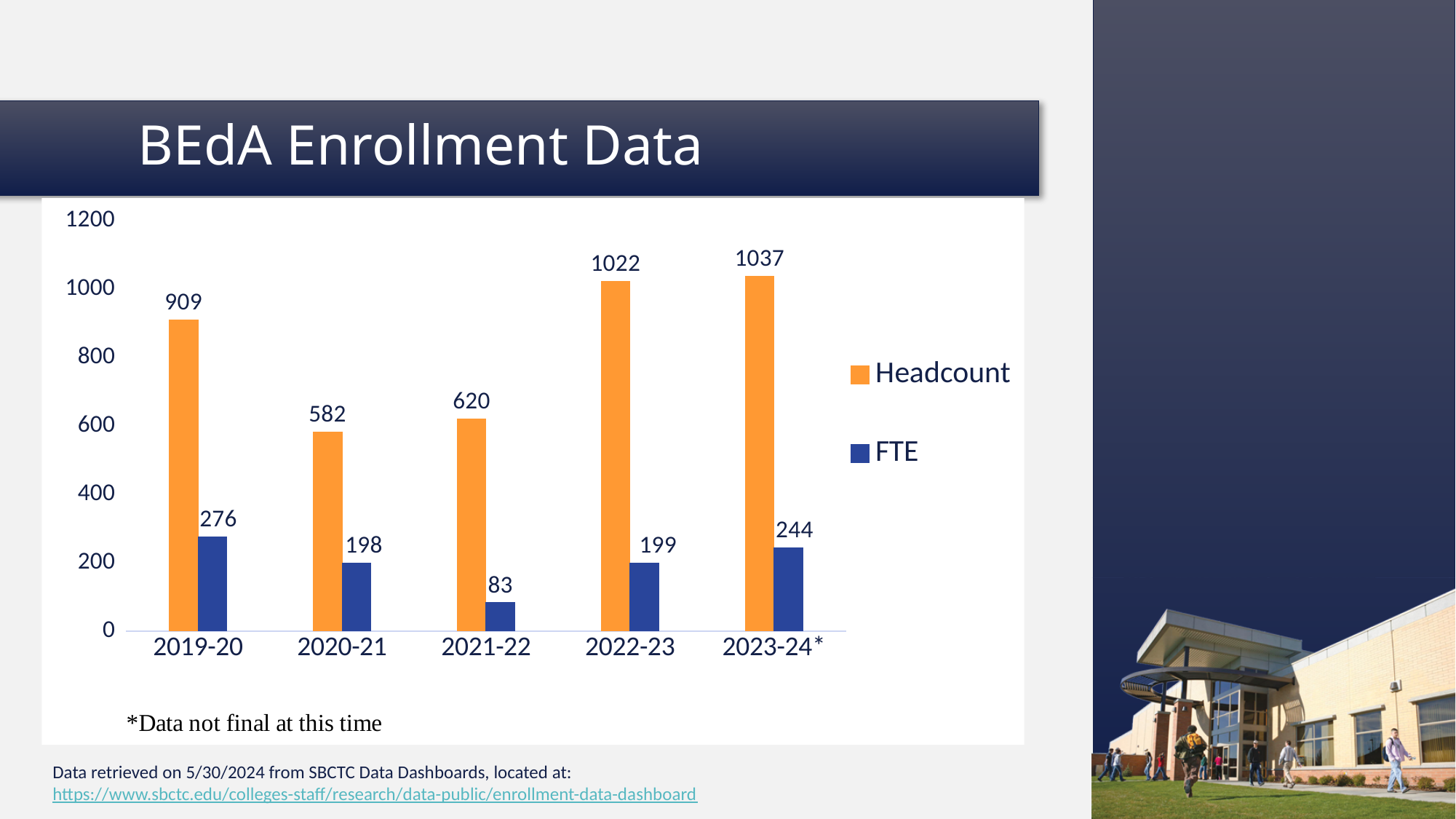
Does the Headcount rise or fall from 2021-22 to 2022-23? rise What is the Headcount value for 2019-20? 909 Which is larger, the FTE value for 2019-20 or the FTE value for 2023-24*? 2019-20 What is the Headcount value for 2023-24*? 1037 What kind of chart is shown on the slide? bar chart How many series does the legend list? 2 What is the FTE value for 2021-22? 83 Which year has the highest Headcount? 2023-24* Which colour represents FTE in the legend? blue How many years are shown on the x axis? 5 What is the difference between the Headcount and FTE values for 2022-23? 823 Which year has the lowest FTE? 2021-22